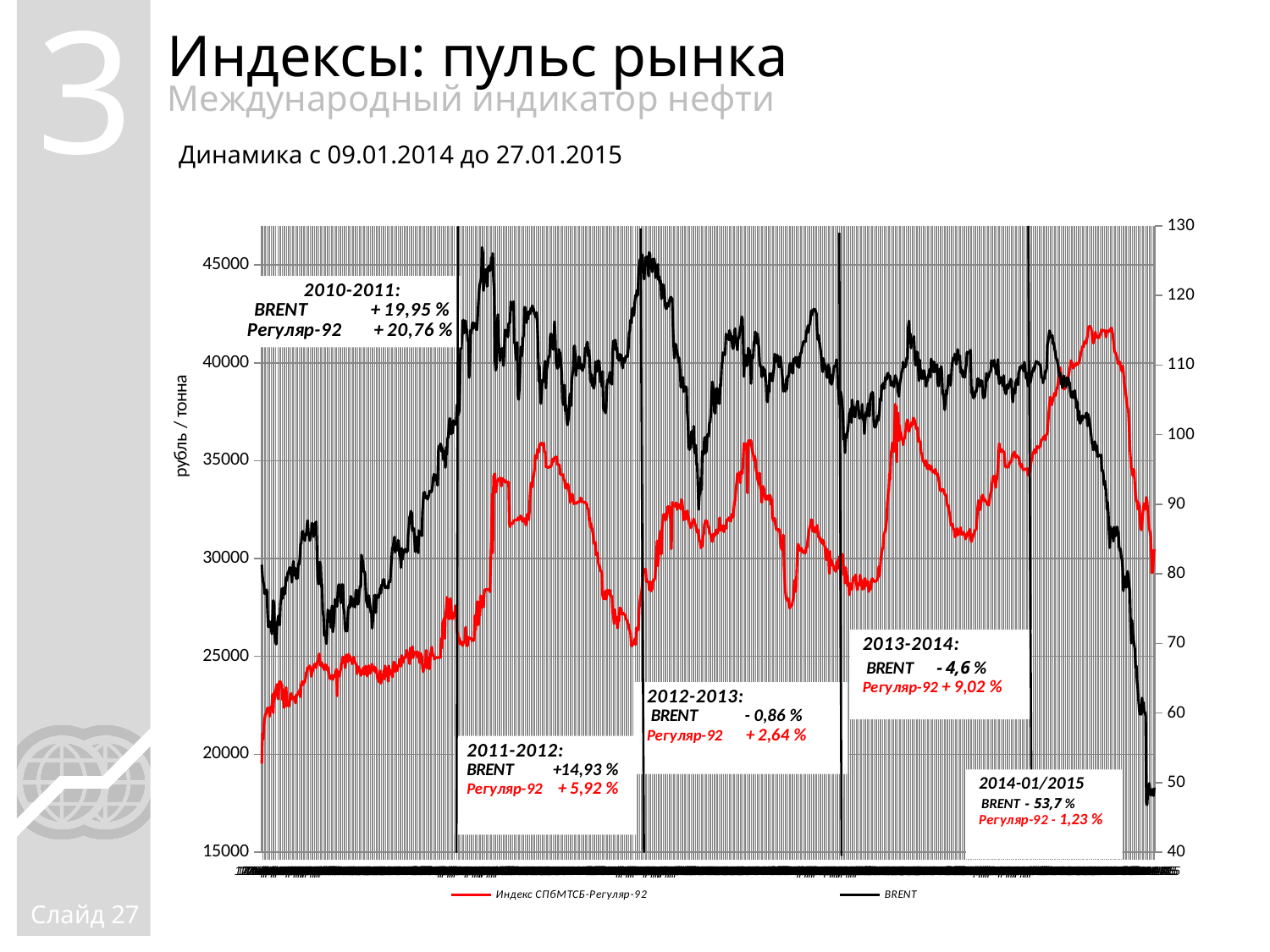
How many annotated periods with percentage changes are shown on the chart? 5 In the final period (2014-01/2015), does the BRENT line rise or fall? fall According to the annotation, what was the change in BRENT for 2012-2013? - 0,86 % Which series is drawn in red according to the legend? Индекс СПбМТСБ-Регуляр-92 Is the highest value reached by the BRENT line greater or less than 120 on the right axis? greater What kind of chart is shown on the slide? line chart How many series does the chart legend list? 2 According to the annotation, what was the change in BRENT for 2010-2011? + 19,95 % According to the annotation, what was the change in Регуляр-92 for 2011-2012? + 5,92 % What is the label of the left vertical axis? рубль / тонна According to the annotation, what was the change in BRENT for 2014-01/2015? - 53,7 % According to the annotation, what was the change in Регуляр-92 for 2013-2014? + 9,02 %